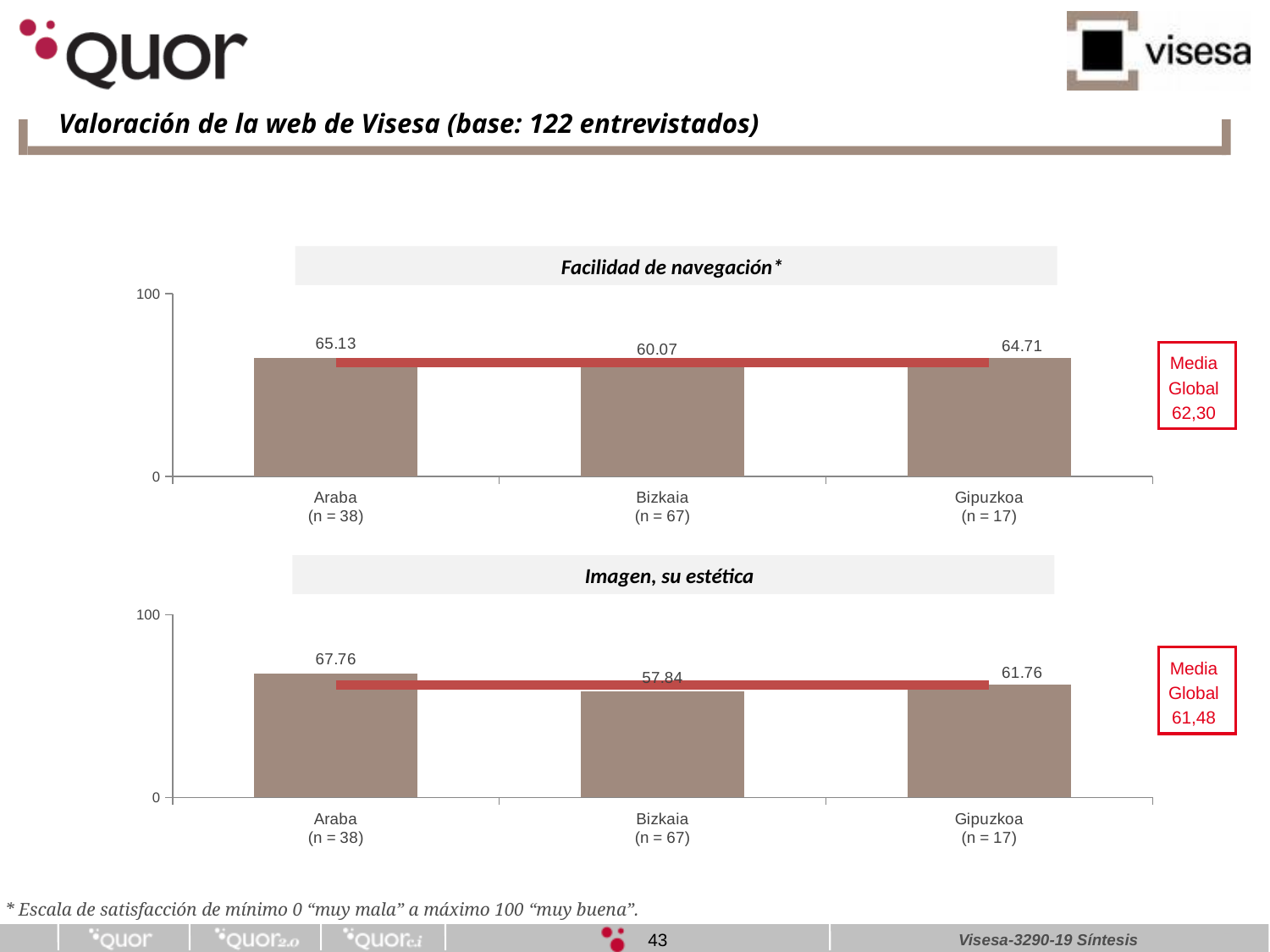
How many categories are shown in the 'Imagen, su estética' chart? 3 In the 'Imagen, su estética' chart, what is the value for Gipuzkoa? 61.76 What kind of chart is the 'Facilidad de navegación' chart? Bar chart What is the 'Media Global' value shown next to the 'Imagen, su estética' chart? 61,48 What is the 'Media Global' value shown next to the 'Facilidad de navegación' chart? 62,30 In the 'Facilidad de navegación' chart, what is the value for Bizkaia? 60.07 In the 'Facilidad de navegación' chart, which category has the lowest value? Bizkaia In the 'Facilidad de navegación' chart, what is the value for Araba? 65.13 In the 'Facilidad de navegación' chart, which is larger, the value for Araba or the value for Gipuzkoa? Araba In the 'Facilidad de navegación' chart, what is the difference between the values for Gipuzkoa and Bizkaia? 4.64 In the 'Imagen, su estética' chart, which category has the highest value? Araba In the 'Imagen, su estética' chart, what is the difference between the values for Araba and Bizkaia? 9.92